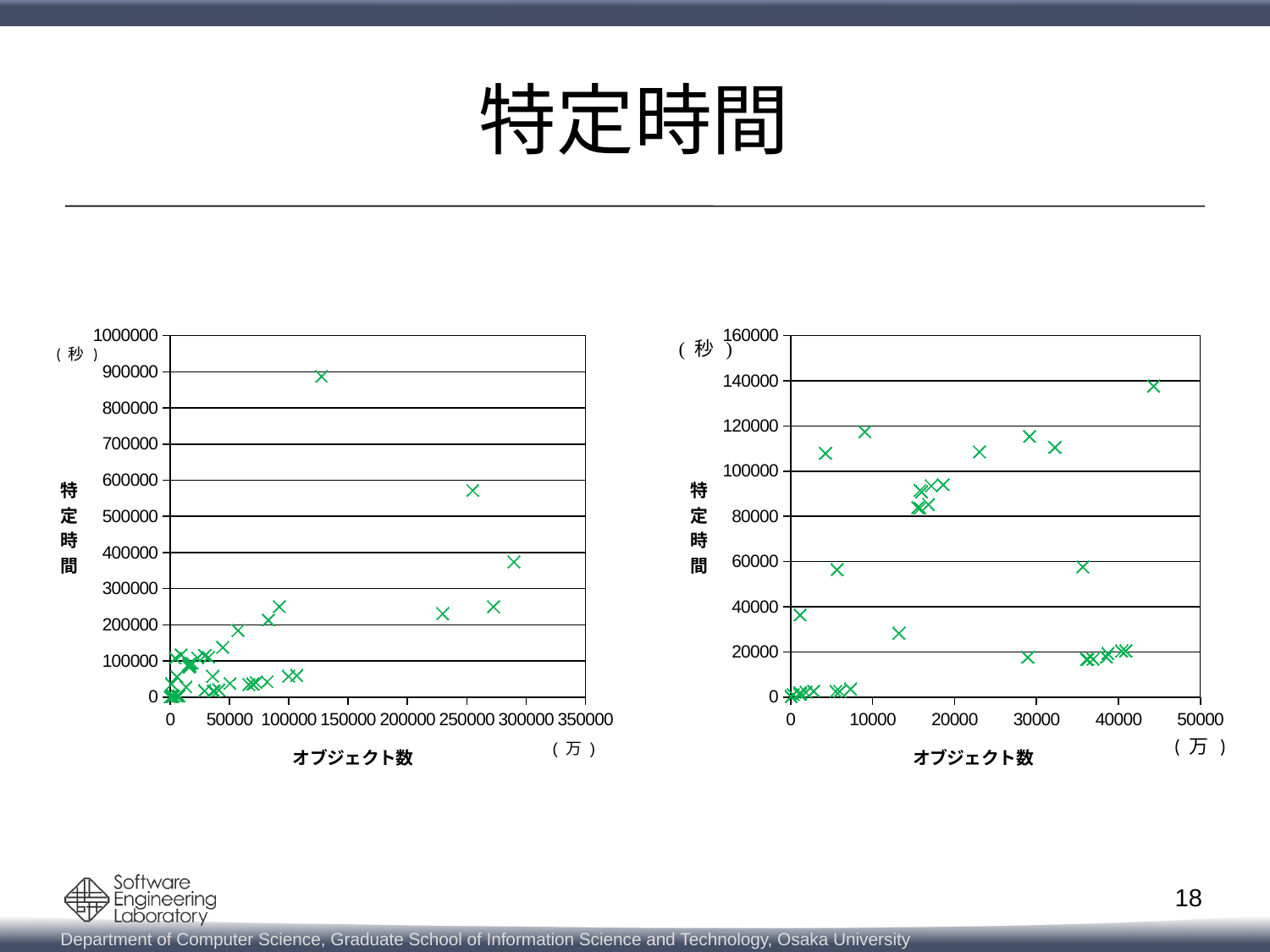
In the left chart, is the value of the point near 290000 on the x axis greater or less than 500000? less In the left chart, is the value of the highest point greater or less than 800000? greater In the right chart, is the value of the point near 13000 on the x axis greater or less than 40000? less In the right chart, what is the label of the y axis? 特定時間 What kind of chart is the left chart on the slide? scatter chart In the left chart, what is the label of the x axis? オブジェクト数 How many charts are shown on the slide? 2 What kind of chart is the right chart on the slide? scatter chart